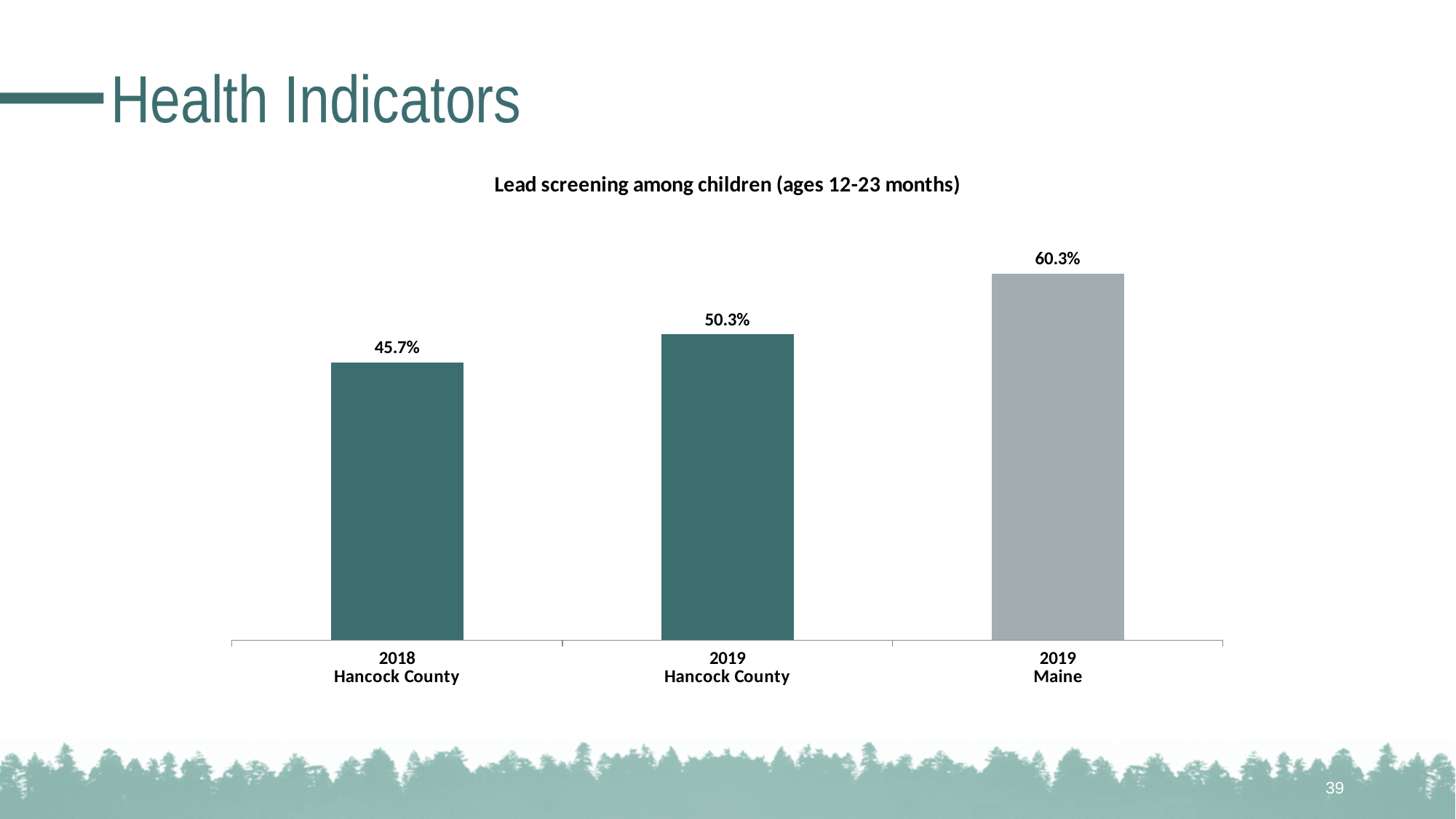
What is the lead screening value for 2018 Hancock County? 45.7% What is the lead screening value for 2019 Maine? 60.3% Do the values rise or fall from left to right across the chart? Rise What kind of chart is shown on the slide? Bar chart What is the difference between the 2019 Hancock County value and the 2018 Hancock County value? 4.6 percentage points What is the title of the chart? Lead screening among children (ages 12-23 months) Which is larger, the 2018 Hancock County value or the 2019 Hancock County value? 2019 Hancock County Which category has the highest lead screening value? 2019 Maine How many bars are shown in the chart? 3 What is the difference between the 2019 Maine value and the 2019 Hancock County value? 10 percentage points Which category has the lowest lead screening value? 2018 Hancock County What is the lead screening value for 2019 Hancock County? 50.3%